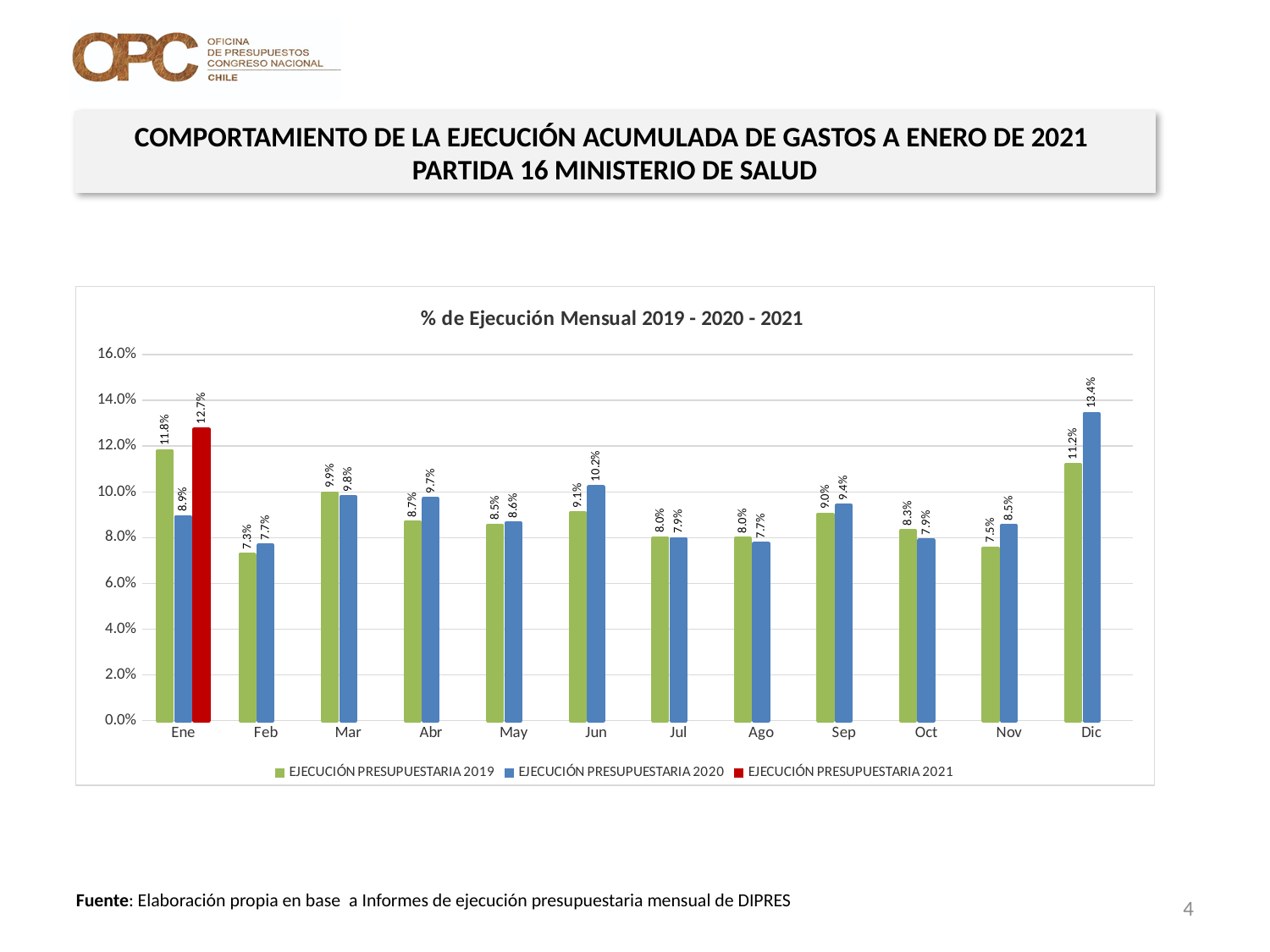
What kind of chart is shown on the slide? Bar chart What is the difference between the EJECUCIÓN PRESUPUESTARIA 2020 and EJECUCIÓN PRESUPUESTARIA 2019 values in Dic? 2.2% Which month has the lowest value for EJECUCIÓN PRESUPUESTARIA 2019? Feb What is the difference between the EJECUCIÓN PRESUPUESTARIA 2021 and EJECUCIÓN PRESUPUESTARIA 2019 values in Ene? 0.9% What is the title of the chart? % de Ejecución Mensual 2019 - 2020 - 2021 How many months are shown on the x axis? 12 Which is larger in Nov: EJECUCIÓN PRESUPUESTARIA 2019 or EJECUCIÓN PRESUPUESTARIA 2020? EJECUCIÓN PRESUPUESTARIA 2020 Which month has the highest value for EJECUCIÓN PRESUPUESTARIA 2020? Dic What is the value for EJECUCIÓN PRESUPUESTARIA 2019 in Dic? 11.2% What is the value for EJECUCIÓN PRESUPUESTARIA 2020 in Jun? 10.2% What is the value for EJECUCIÓN PRESUPUESTARIA 2021 in Ene? 12.7% How many series does the legend list? 3